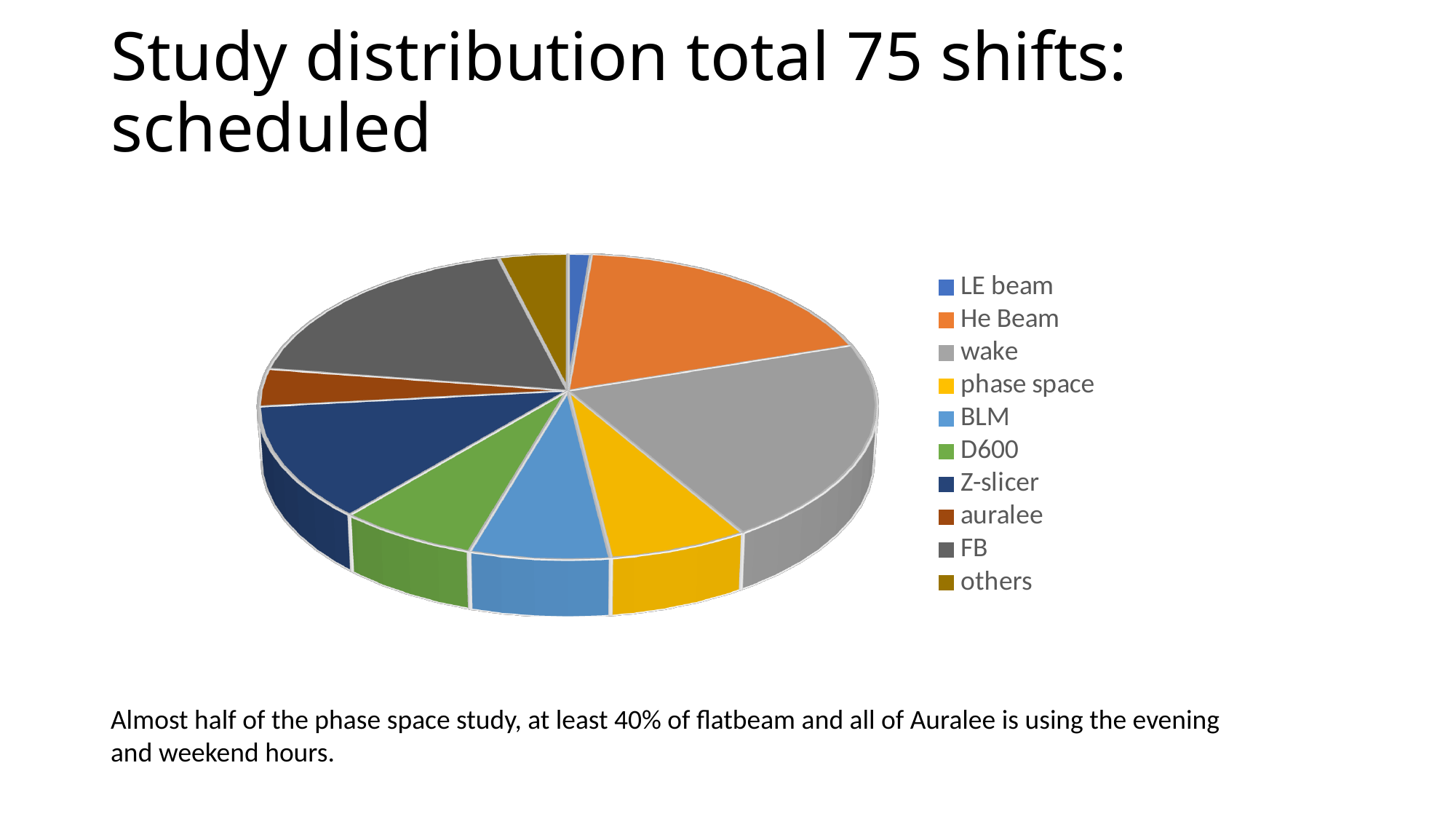
What colour is the wake slice in the pie chart? gray Which category has the largest slice of the pie? wake Which slice is larger, FB or auralee? FB How many categories does the pie chart's legend list? 10 What kind of chart is shown on the slide? pie chart Which slice is larger, Z-slicer or LE beam? Z-slicer Which category has the smallest slice of the pie? LE beam Which category is listed first in the legend? LE beam Which slice is larger, FB or others? FB